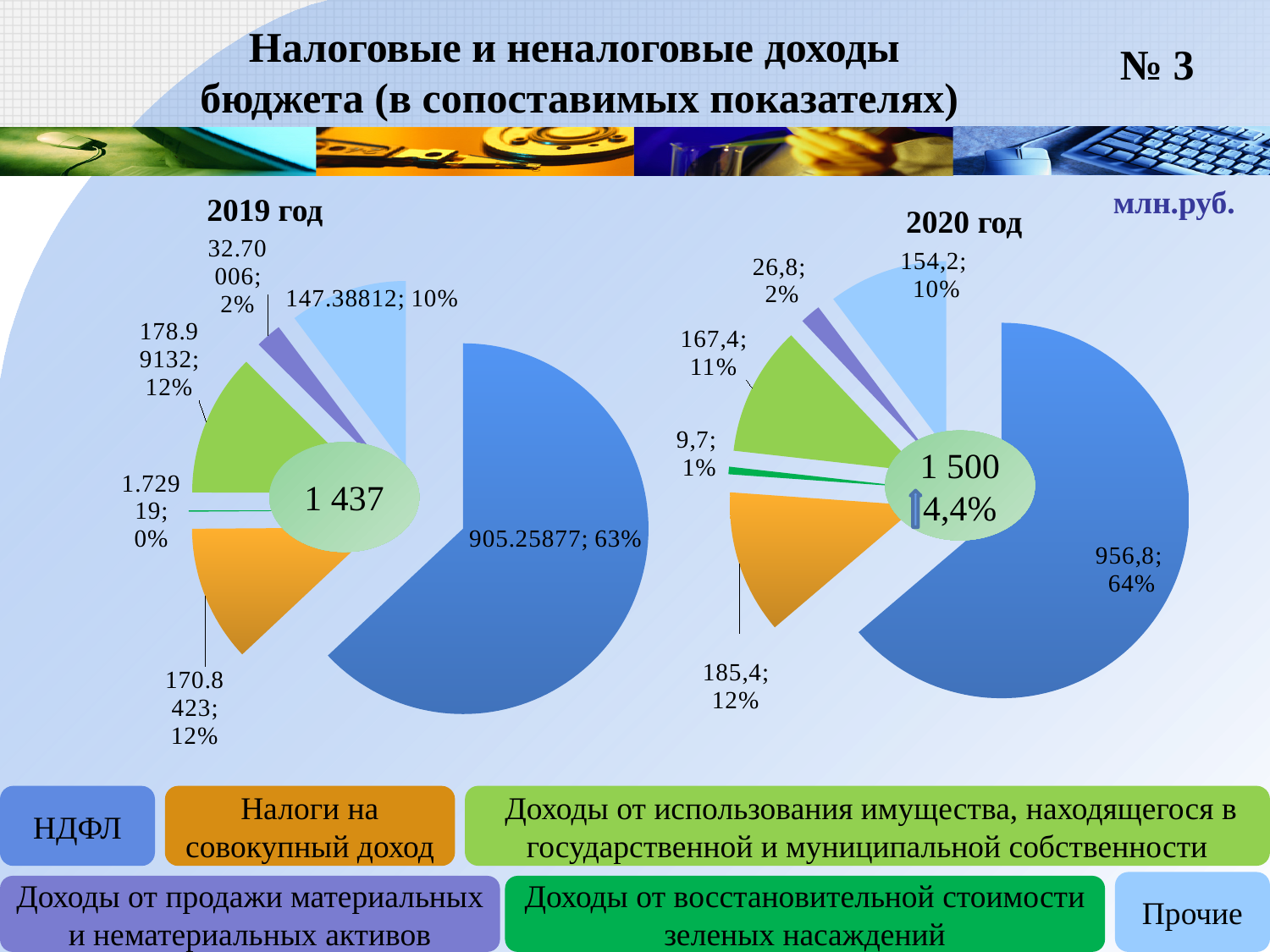
How many categories does the legend at the bottom of the slide list? 6 In the 2019 год chart, what is the value for Прочие? 147.38812 In the 2020 год chart, which is larger: Налоги на совокупный доход or Доходы от использования имущества, находящегося в государственной и муниципальной собственности? Налоги на совокупный доход In the 2020 год chart, what is the value for Налоги на совокупный доход? 185,4 In the 2020 год chart, what share of the pie does Прочие take? 10% In the 2020 год chart, which category has the smallest slice? Доходы от восстановительной стоимости зеленых насаждений In the 2020 год chart, which category has the largest slice? НДФЛ In the 2020 год chart, what is the difference between the values for НДФЛ and Прочие? 802,6 In the 2020 год chart, what is the value for НДФЛ? 956,8 In the 2019 год chart, what share of the pie does НДФЛ take? 63% What total is shown in the centre of the 2020 год chart? 1 500 What kind of chart is used for the 2019 год data? pie chart